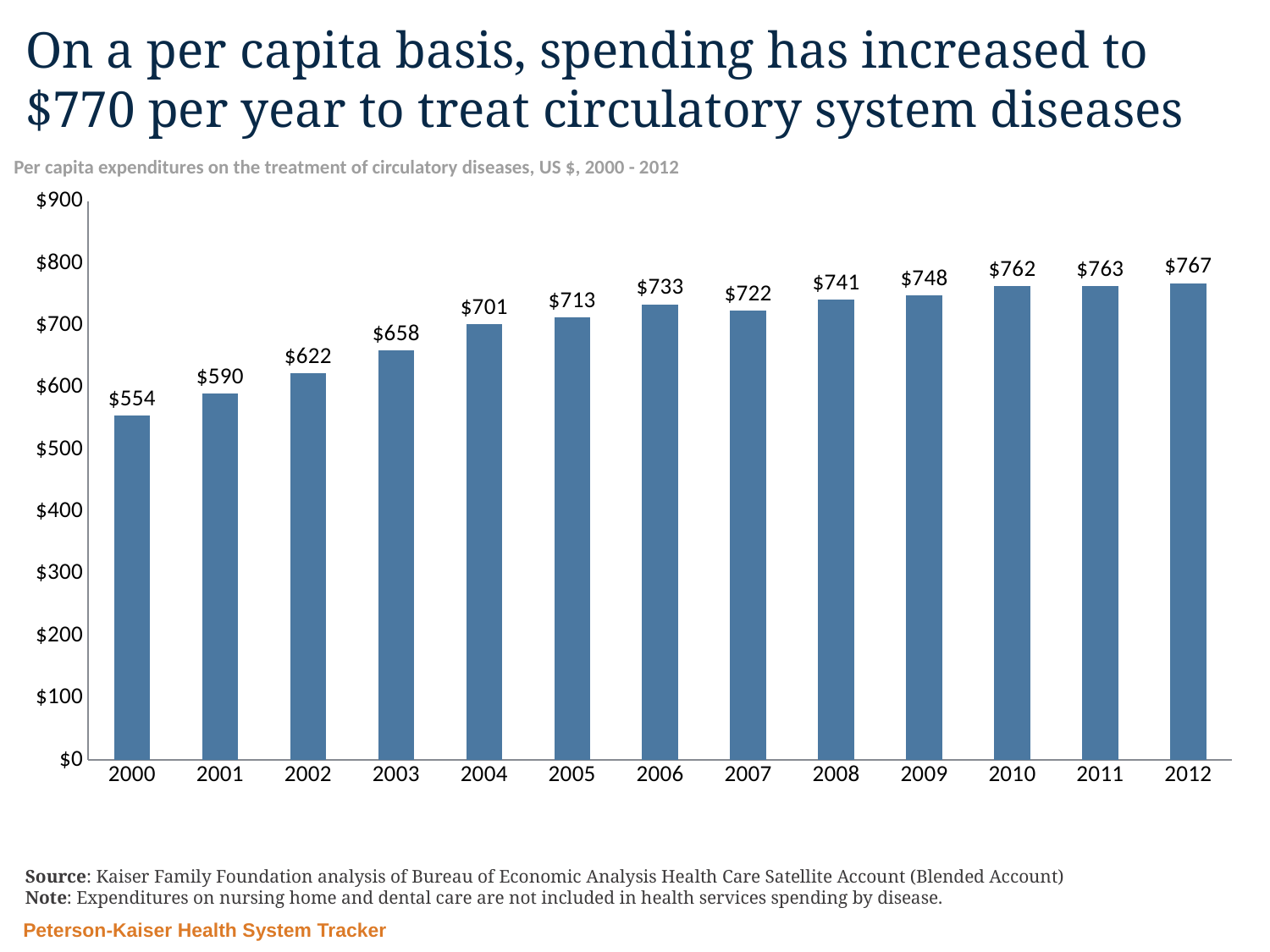
Which year had a higher per capita expenditure, 2006 or 2007? 2006 How many years are shown on the chart? 13 What was the per capita expenditure on the treatment of circulatory diseases in 2012? $767 What is the overall trend in per capita expenditure from 2000 to 2012? Rising What is the difference between the per capita expenditure in 2006 and in 2007? $11 Which year has the lowest per capita expenditure on circulatory diseases? 2000 What was the per capita expenditure on the treatment of circulatory diseases in 2000? $554 What kind of chart is shown on the slide? Bar chart Is the per capita expenditure for 2003 greater or less than $700? less Which year has the highest per capita expenditure on circulatory diseases? 2012 What is the difference between the per capita expenditure in 2012 and in 2000? $213 What was the per capita expenditure on the treatment of circulatory diseases in 2007? $722